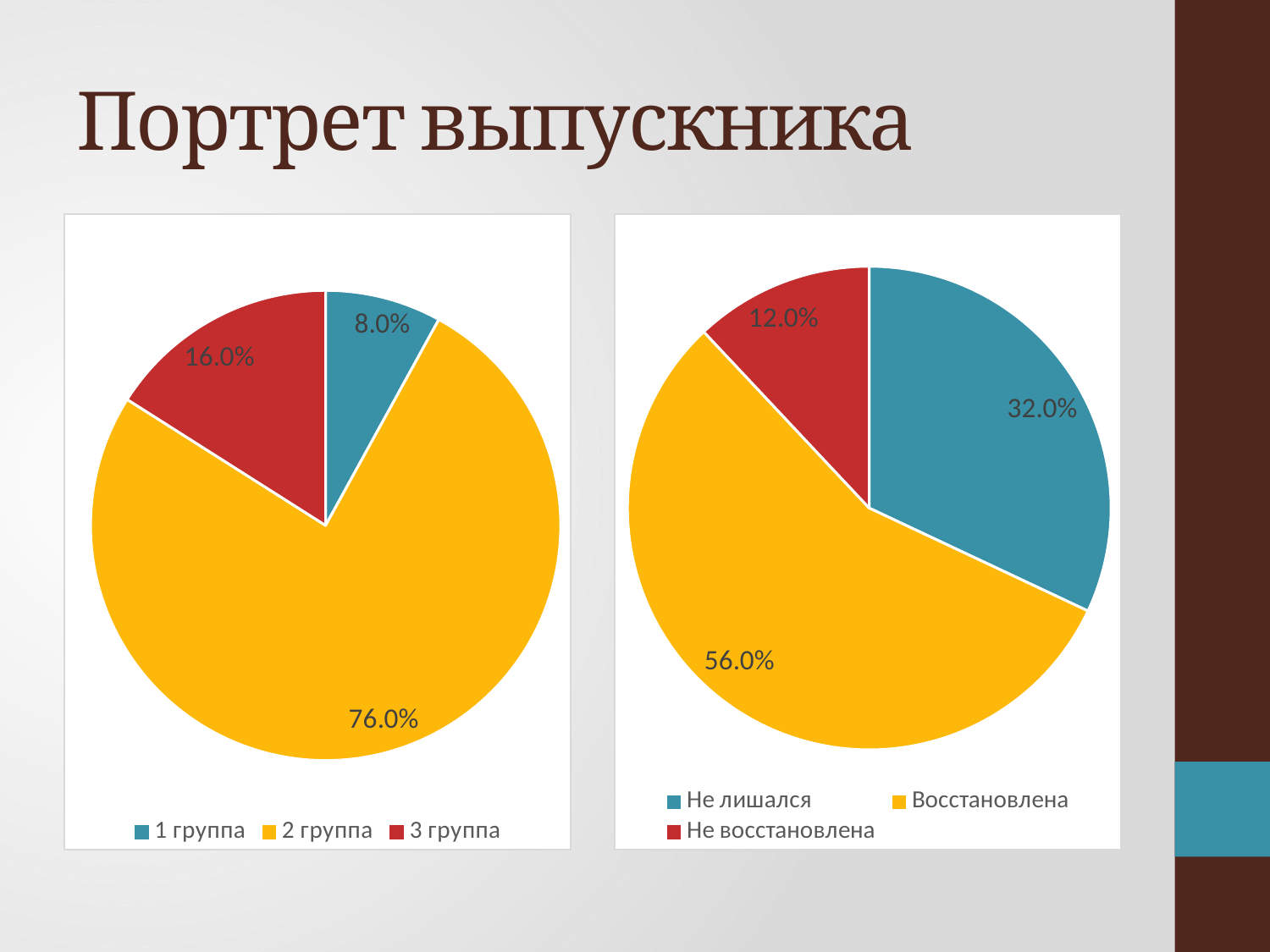
In the left pie chart, what share does '1 группа' have? 8.0% In the left pie chart, what is the difference between the shares of '3 группа' and '1 группа'? 8.0% In the right pie chart, what share does 'Восстановлена' have? 56.0% In the right pie chart, which category has the smallest share? Не восстановлена In the left pie chart, which group has the smallest share? 1 группа In the right pie chart, what share does 'Не лишался' have? 32.0% In the left pie chart, what share does '2 группа' have? 76.0% In the right pie chart, which is larger: 'Не лишался' or 'Не восстановлена'? Не лишался In the left pie chart, how many slices are there? 3 What type of chart is shown on the right side of the slide? Pie chart In the left pie chart, which group has the largest share? 2 группа In the right pie chart, what is the difference between the shares of 'Восстановлена' and 'Не лишался'? 24.0%